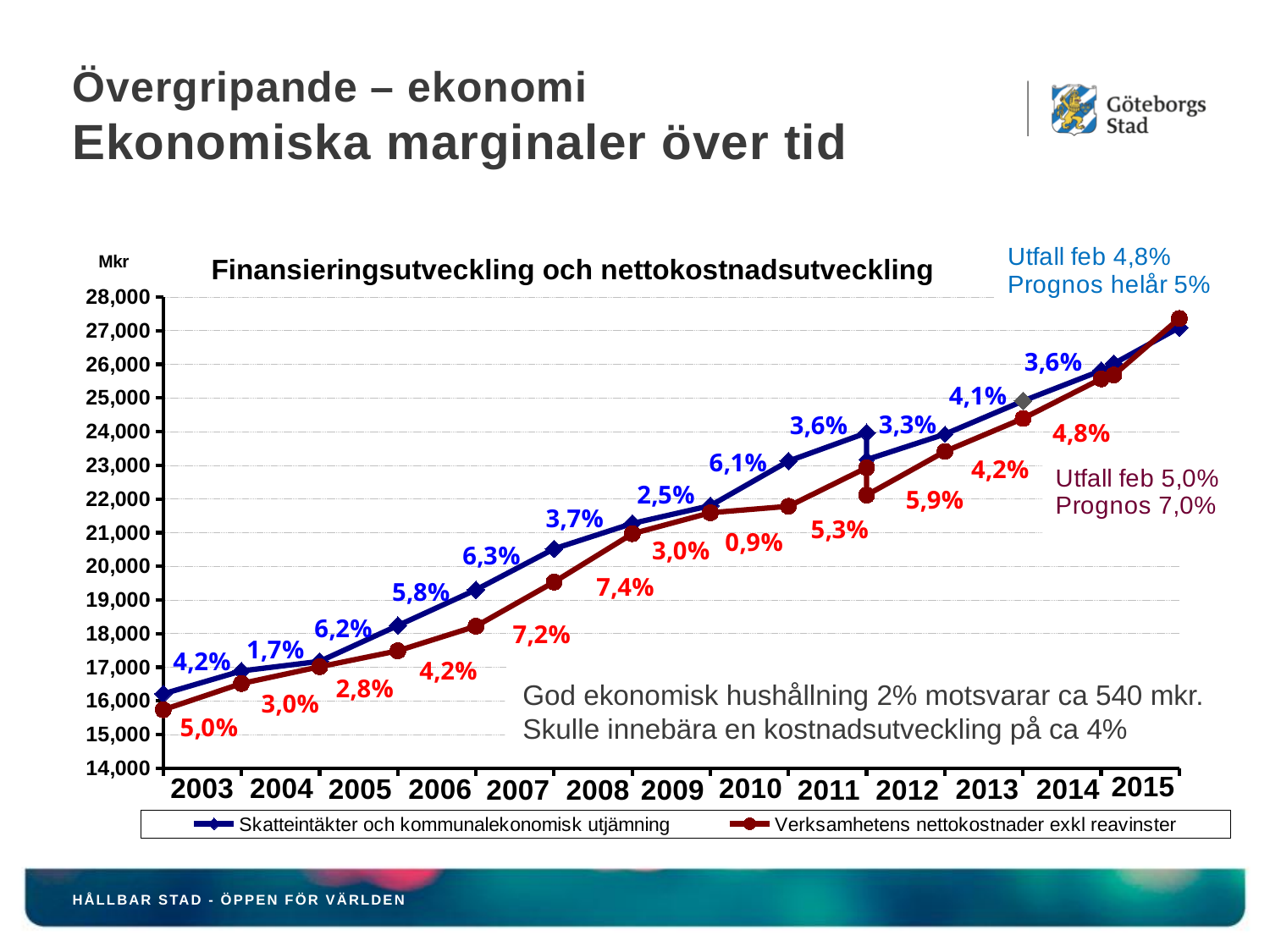
Do the values of the blue series generally rise or fall from 2003 to 2015? Rise What percentage label is shown for the red series at 2008? 7,4% How many series does the chart legend list? 2 How many years are shown on the x axis of the chart? 13 Is the value of the red series (Verksamhetens nettokostnader exkl reavinster) in 2003 greater or less than 16,000? less Is the value of the red series (Verksamhetens nettokostnader exkl reavinster) in 2014 greater or less than 25,000? greater What percentage label is shown for the red series (Verksamhetens nettokostnader exkl reavinster) at 2010? 0,9% What percentage label is shown for the blue series (Skatteintäkter och kommunalekonomisk utjämning) at 2007? 6,3% What is the title of the chart? Finansieringsutveckling och nettokostnadsutveckling Which year has the highest percentage label on the red series (Verksamhetens nettokostnader exkl reavinster)? 2008 Which year has the lowest percentage label on the blue series (Skatteintäkter och kommunalekonomisk utjämning)? 2004 What type of chart is shown on the slide? Line chart